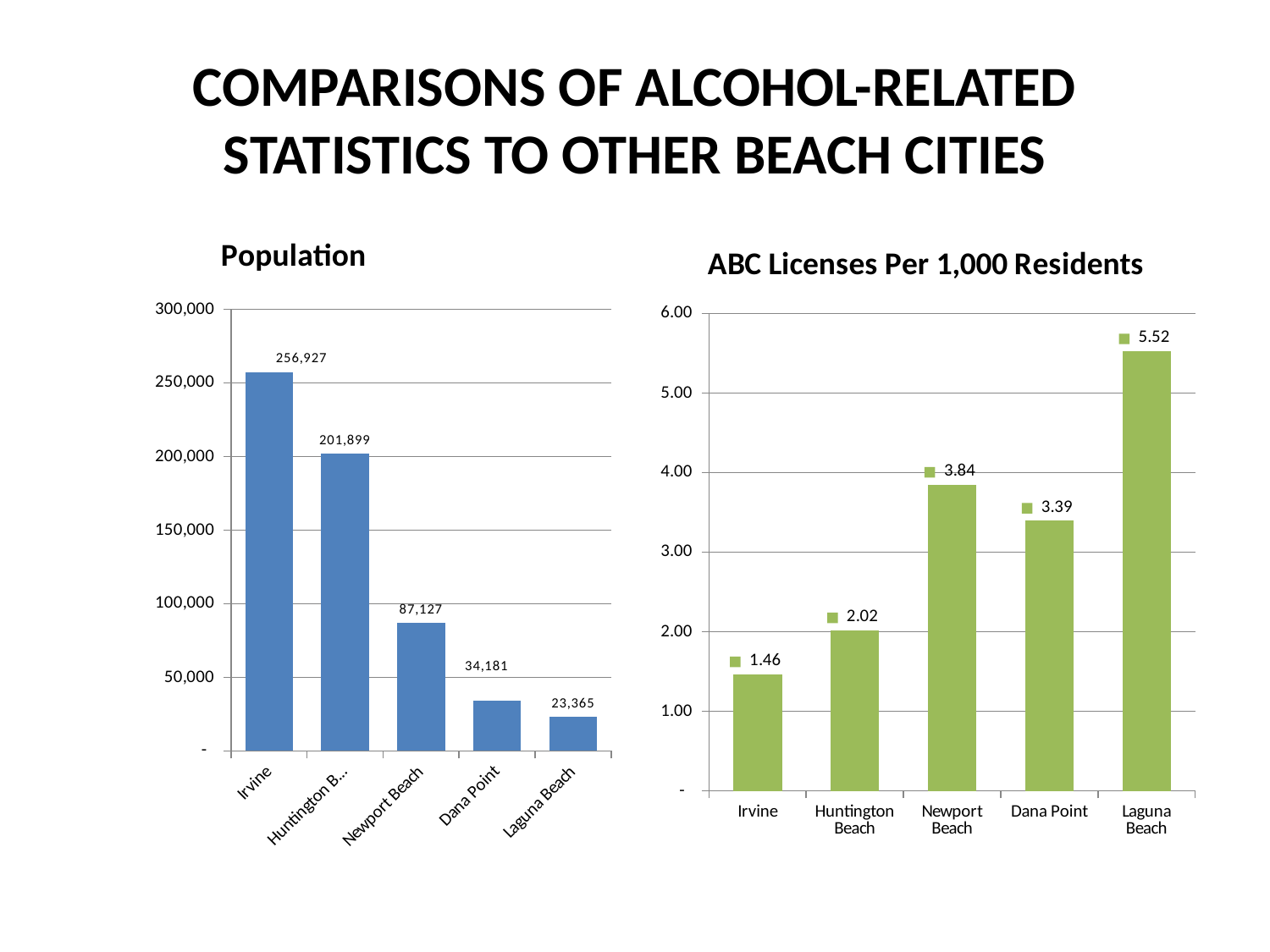
In the Population chart, how many cities are shown? 5 What type of chart is the Population chart? bar chart In the Population chart, what is the population of Irvine? 256,927 In the ABC Licenses Per 1,000 Residents chart, what is the value for Irvine? 1.46 In the ABC Licenses Per 1,000 Residents chart, which is larger, the value for Huntington Beach or the value for Dana Point? Dana Point In the ABC Licenses Per 1,000 Residents chart, which city has the highest value? Laguna Beach In the Population chart, what is the difference in population between Dana Point and Laguna Beach? 10,816 In the ABC Licenses Per 1,000 Residents chart, what is the value for Dana Point? 3.39 In the Population chart, what is the population of Newport Beach? 87,127 In the ABC Licenses Per 1,000 Residents chart, do the values generally rise or fall from left to right? rise In the ABC Licenses Per 1,000 Residents chart, what is the difference between Laguna Beach and Newport Beach? 1.68 In the Population chart, which city has the lowest population? Laguna Beach